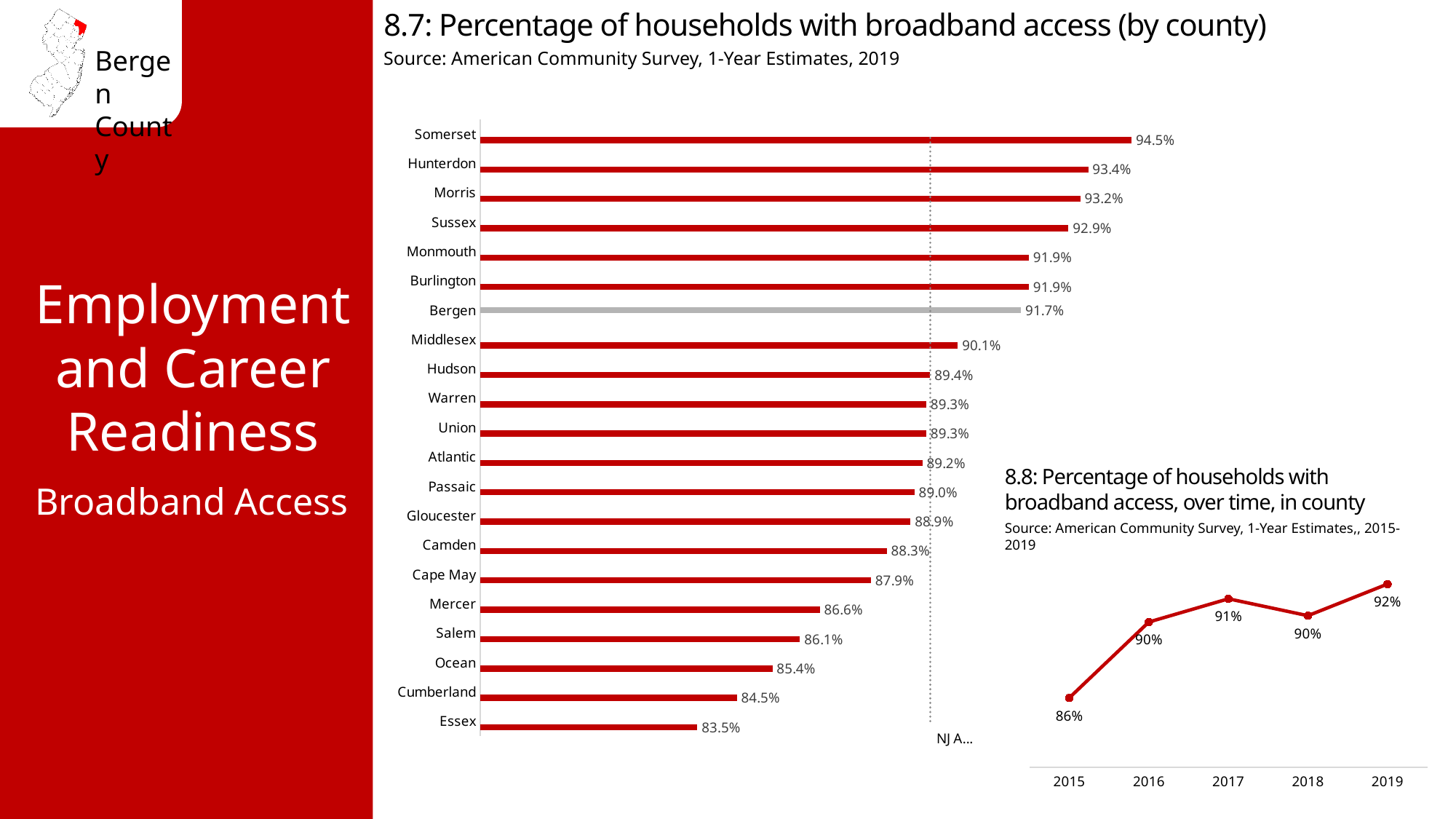
In chart 8.7, what is the difference between Somerset's value and Essex's value? 11.0% In chart 8.8, how many years are plotted? 5 In chart 8.7, which county has the highest percentage of households with broadband access? Somerset In chart 8.7, what is the percentage of households with broadband access in Bergen County? 91.7% In chart 8.8, which year has the highest percentage? 2019 In chart 8.8, what was the percentage of households with broadband access in 2015? 86% In chart 8.7, which county has a higher value, Middlesex or Mercer? Middlesex In chart 8.7, how many counties are shown? 21 In chart 8.7, what is the value for Cumberland? 84.5% In chart 8.7, which county has the lowest percentage of households with broadband access? Essex What kind of chart is chart 8.7? Bar chart In chart 8.8, what is the difference between the 2019 value and the 2015 value? 6%